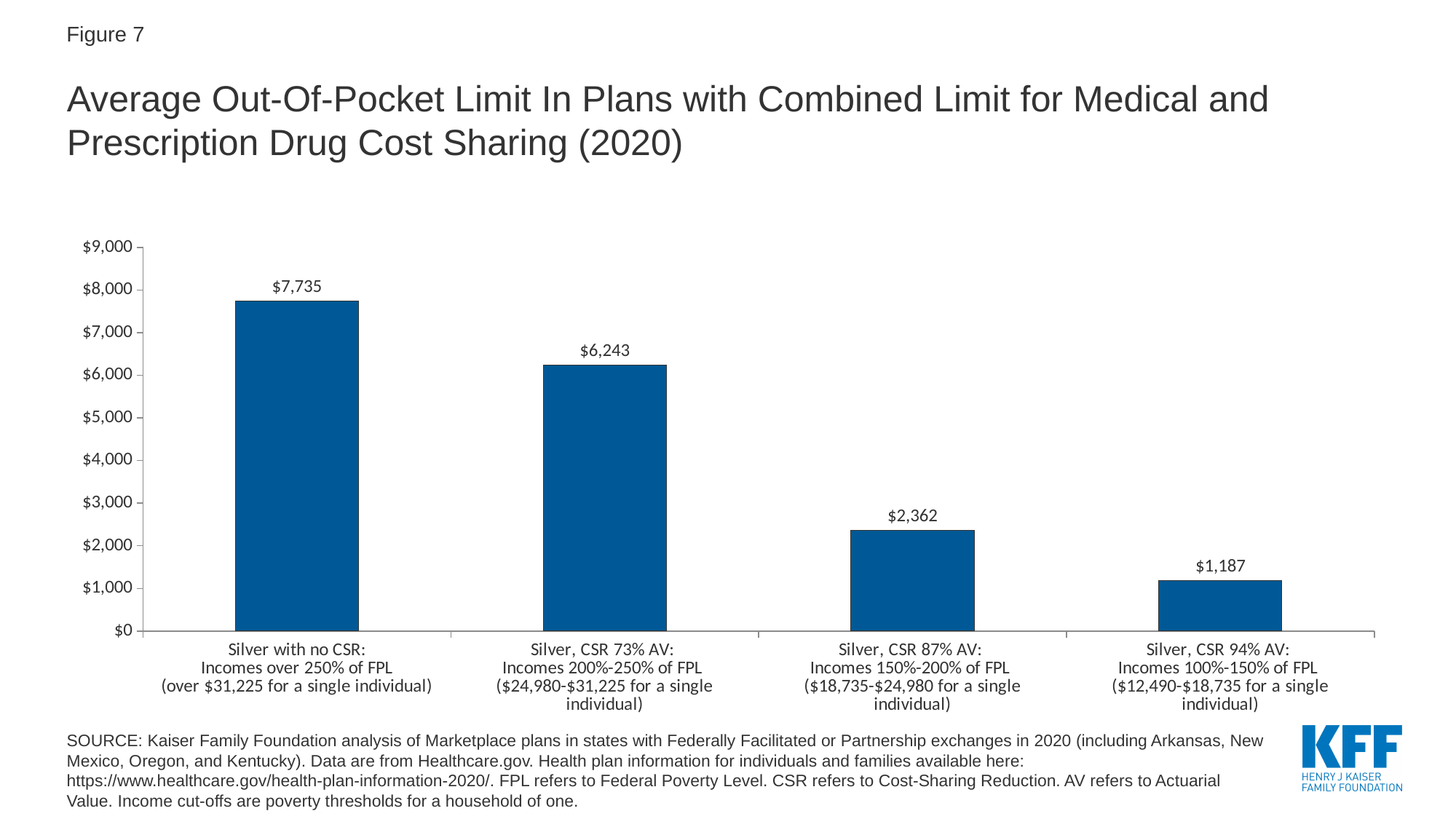
What is the average out-of-pocket limit for Silver, CSR 73% AV plans? $6,243 Which plan category has the lowest average out-of-pocket limit? Silver, CSR 94% AV Which has a larger average out-of-pocket limit: Silver, CSR 73% AV or Silver, CSR 87% AV? Silver, CSR 73% AV How many plan categories are shown in the chart? 4 What kind of chart is shown on the slide? Bar chart Do the values rise or fall moving from left to right across the categories? Fall What is the average out-of-pocket limit for Silver, CSR 94% AV plans? $1,187 Which plan category has the highest average out-of-pocket limit? Silver with no CSR What is the difference between the average out-of-pocket limit for Silver with no CSR and Silver, CSR 73% AV? $1,492 What is the difference between the average out-of-pocket limit for Silver, CSR 87% AV and Silver, CSR 94% AV? $1,175 What is the average out-of-pocket limit for Silver, CSR 87% AV plans? $2,362 What is the average out-of-pocket limit for Silver plans with no CSR (incomes over 250% of FPL)? $7,735